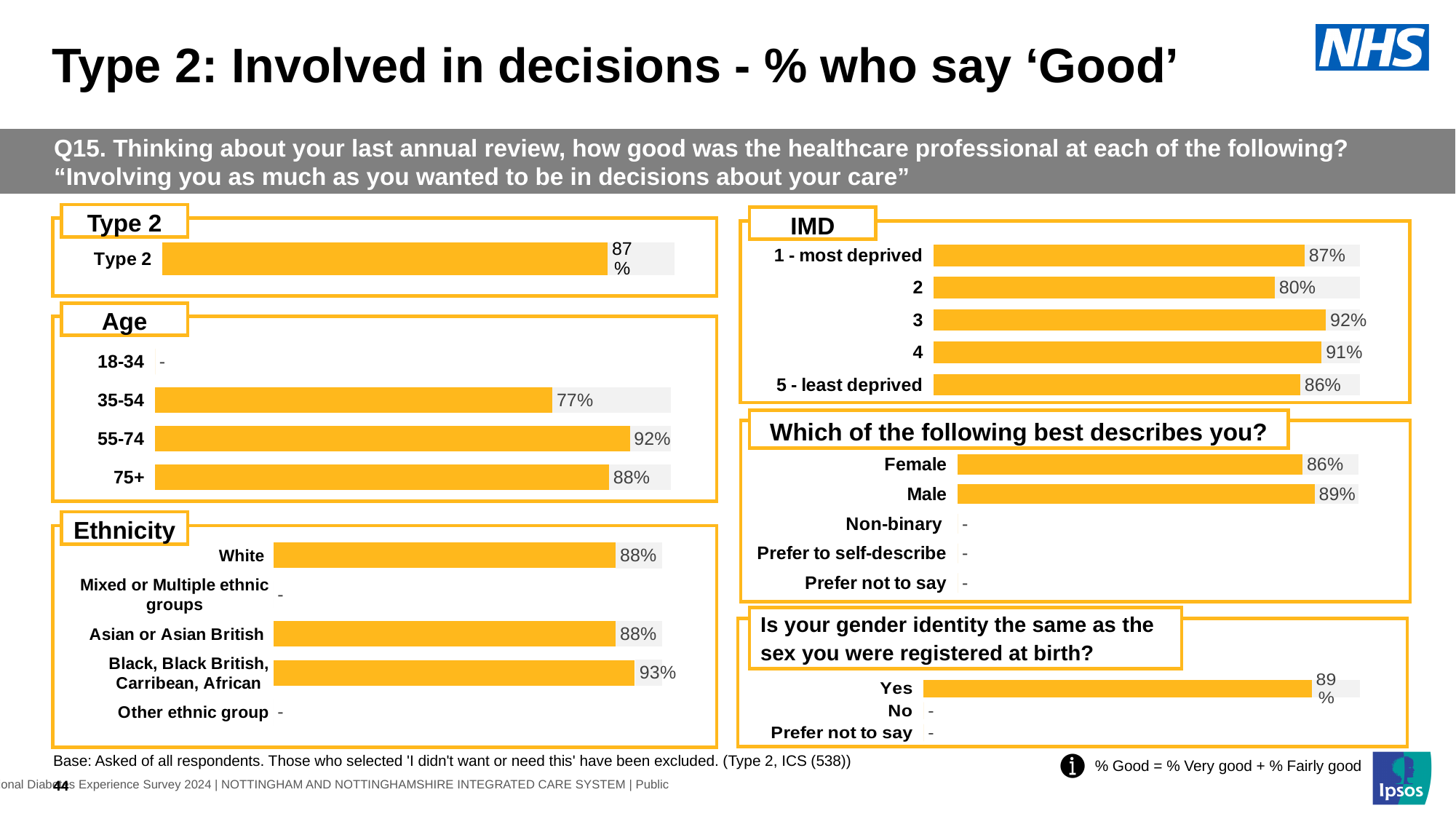
In the IMD chart, which category has the lowest value? 2 In the Age chart, which age group has the highest value? 55-74 In the Age chart, what is the difference between the values for 55-74 and 35-54? 15 percentage points In the Ethnicity chart, what is the value for Black, Black British, Carribean, African? 93% In the Type 2 chart, what is the value shown for Type 2? 87% In the 'Is your gender identity the same as the sex you were registered at birth?' chart, what is the value for Yes? 89% In the 'Which of the following best describes you?' chart, which is larger, the value for Female or for Male? Male In the Age chart, what is the value for the 35-54 group? 77% How many categories are shown in the IMD chart? 5 In the IMD chart, which category has the highest value? 3 In the IMD chart, what is the difference between the values for category 3 and category 2? 12 percentage points What kind of chart is the IMD chart? Bar chart